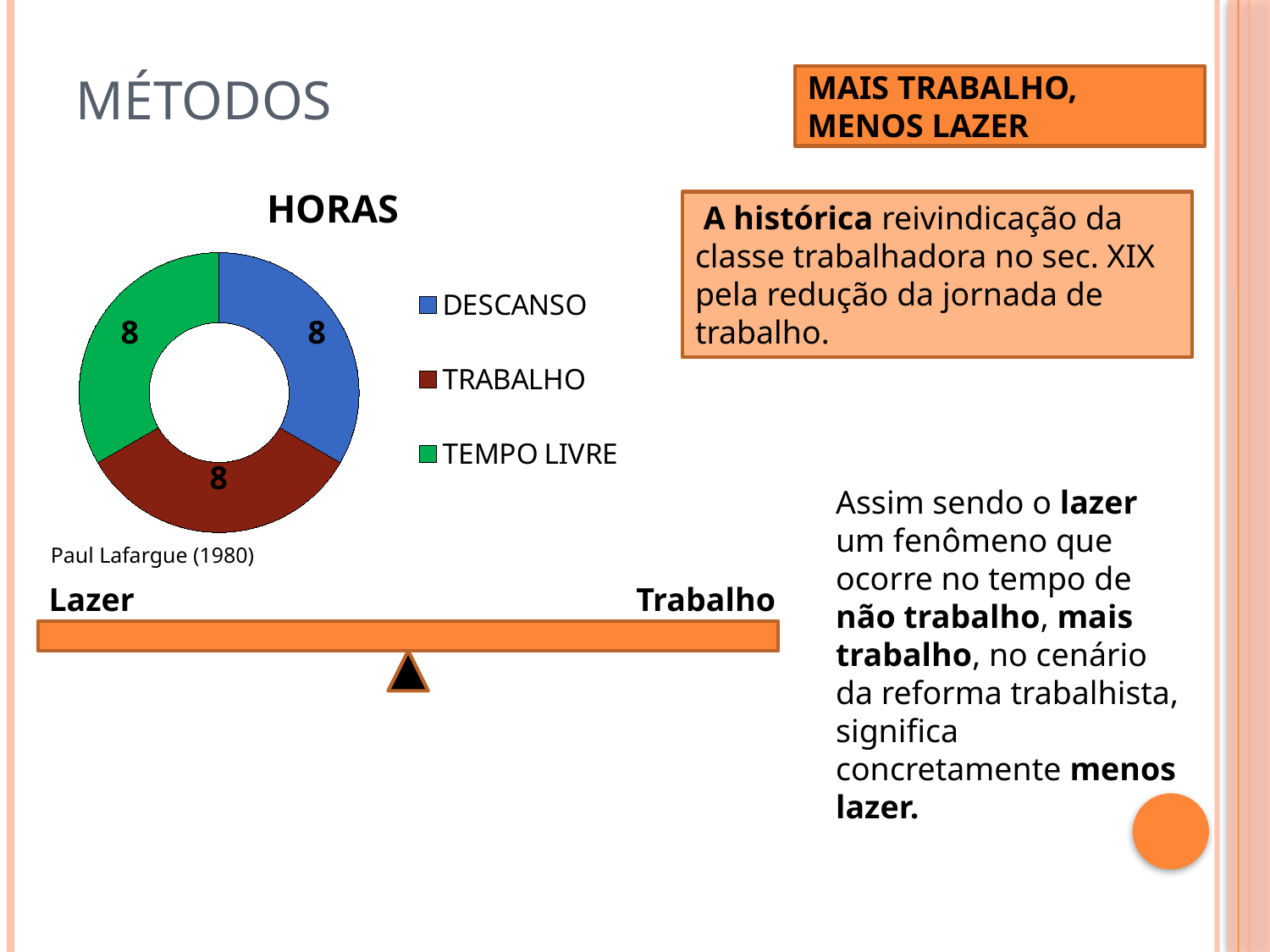
What kind of chart is shown on the slide? Doughnut chart How many categories does the HORAS chart show? 3 What is the value for DESCANSO in the HORAS chart? 8 How many entries does the legend of the HORAS chart list? 3 What share of the HORAS chart does the TRABALHO slice represent? One third What is the title of the chart? HORAS What is the difference between the values for DESCANSO and TRABALHO in the HORAS chart? 0 What is the total of all the values in the HORAS chart? 24 What is the value for TRABALHO in the HORAS chart? 8 What is the value for TEMPO LIVRE in the HORAS chart? 8 Which colour represents TEMPO LIVRE in the HORAS chart? Green Is the value for DESCANSO in the HORAS chart equal to the value for TEMPO LIVRE? Yes